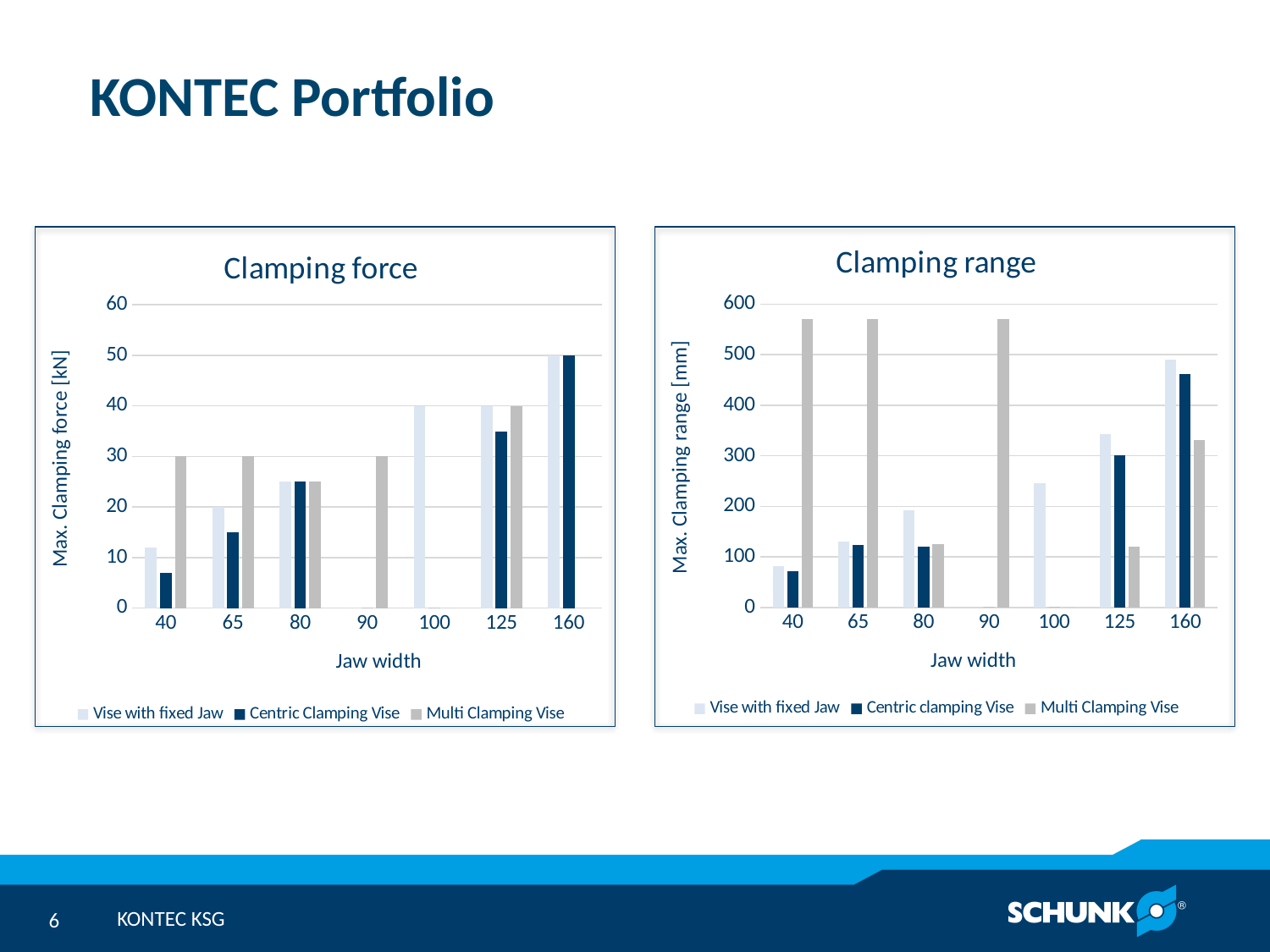
In the Clamping force chart, what is the difference between the Vise with fixed Jaw values at jaw widths 160 and 100? 10 In the Clamping force chart, what is the value for Vise with fixed Jaw at jaw width 100? 40 What kind of chart is the Clamping force chart? bar chart In the Clamping force chart, at which jaw width is the Centric Clamping Vise value highest? 160 How many series does the legend of the Clamping range chart list? 3 In the Clamping range chart, is the value for Multi Clamping Vise at jaw width 40 greater or less than 500? greater In the Clamping force chart, what is the value for Vise with fixed Jaw at jaw width 160? 50 In the Clamping force chart, is the value for Centric Clamping Vise at jaw width 40 greater or less than 10? less In the Clamping range chart, at jaw width 160, which is larger: Vise with fixed Jaw or Multi Clamping Vise? Vise with fixed Jaw How many jaw width categories are shown on the x axis of the Clamping force chart? 7 In the Clamping force chart, what is the value for Multi Clamping Vise at jaw width 40? 30